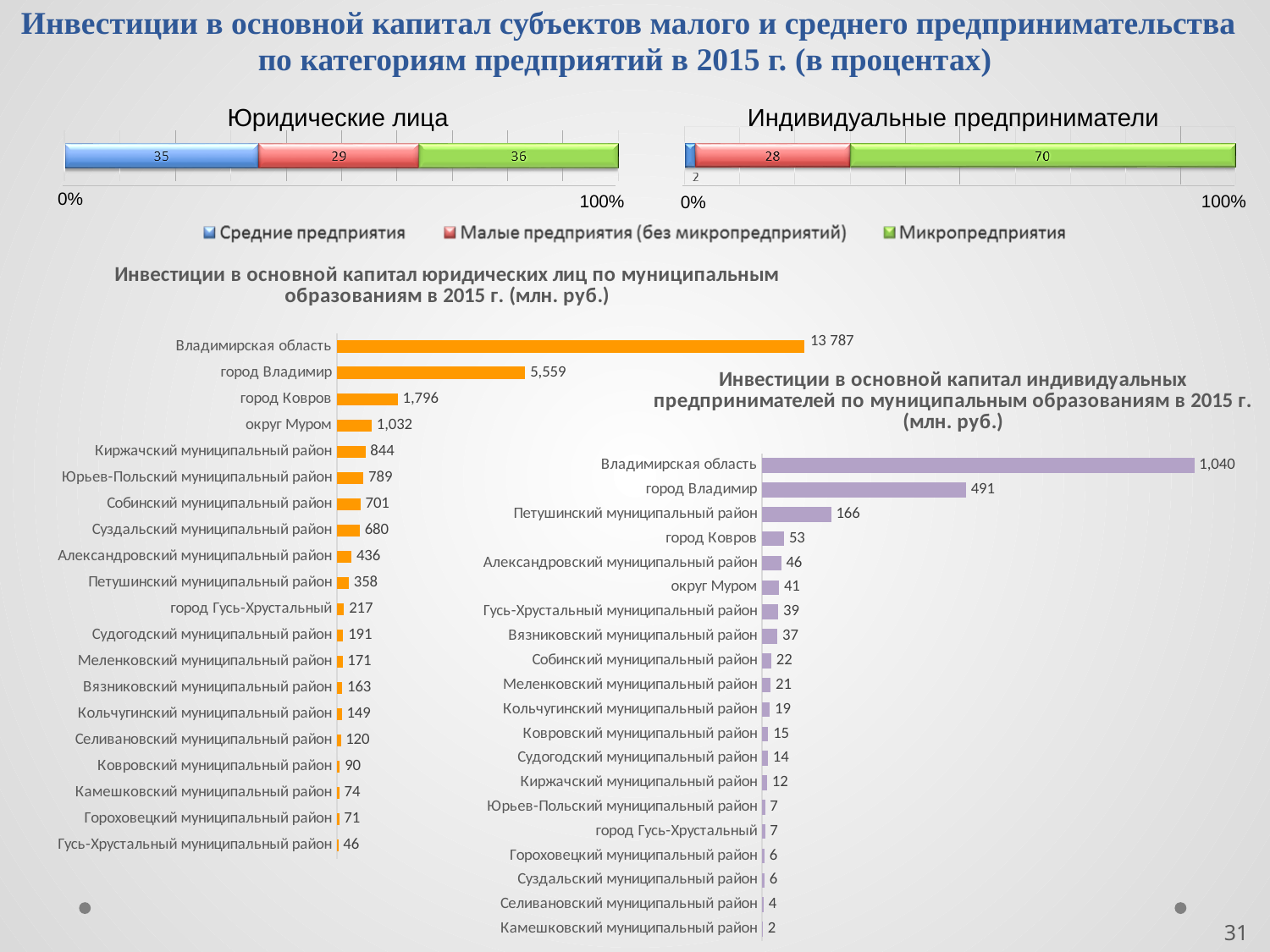
What kind of chart is 'Инвестиции в основной капитал индивидуальных предпринимателей по муниципальным образованиям в 2015 г. (млн. руб.)'? Bar chart In the chart 'Инвестиции в основной капитал юридических лиц по муниципальным образованиям в 2015 г. (млн. руб.)', how many categories are shown? 20 In the chart 'Инвестиции в основной капитал юридических лиц по муниципальным образованиям в 2015 г. (млн. руб.)', what is the difference between 'Киржачский муниципальный район' and 'Юрьев-Польский муниципальный район'? 55 In the 'Юридические лица' stacked bar chart, which segment is the largest? Микропредприятия In the 'Юридические лица' stacked bar chart, what is the value for 'Малые предприятия (без микропредприятий)'? 29 In the 'Индивидуальные предприниматели' stacked bar chart, what is the value for 'Микропредприятия'? 70 In the chart 'Инвестиции в основной капитал индивидуальных предпринимателей по муниципальным образованиям в 2015 г. (млн. руб.)', which is larger: 'город Ковров' or 'округ Муром'? город Ковров In the 'Индивидуальные предприниматели' stacked bar chart, what is the value for 'Средние предприятия'? 2 How many series does the legend list for the two stacked bar charts at the top of the slide? 3 In the chart 'Инвестиции в основной капитал индивидуальных предпринимателей по муниципальным образованиям в 2015 г. (млн. руб.)', what is the value for 'Петушинский муниципальный район'? 166 In the chart 'Инвестиции в основной капитал юридических лиц по муниципальным образованиям в 2015 г. (млн. руб.)', what is the value for 'город Ковров'? 1,796 In the chart 'Инвестиции в основной капитал юридических лиц по муниципальным образованиям в 2015 г. (млн. руб.)', which category has the lowest value? Гусь-Хрустальный муниципальный район